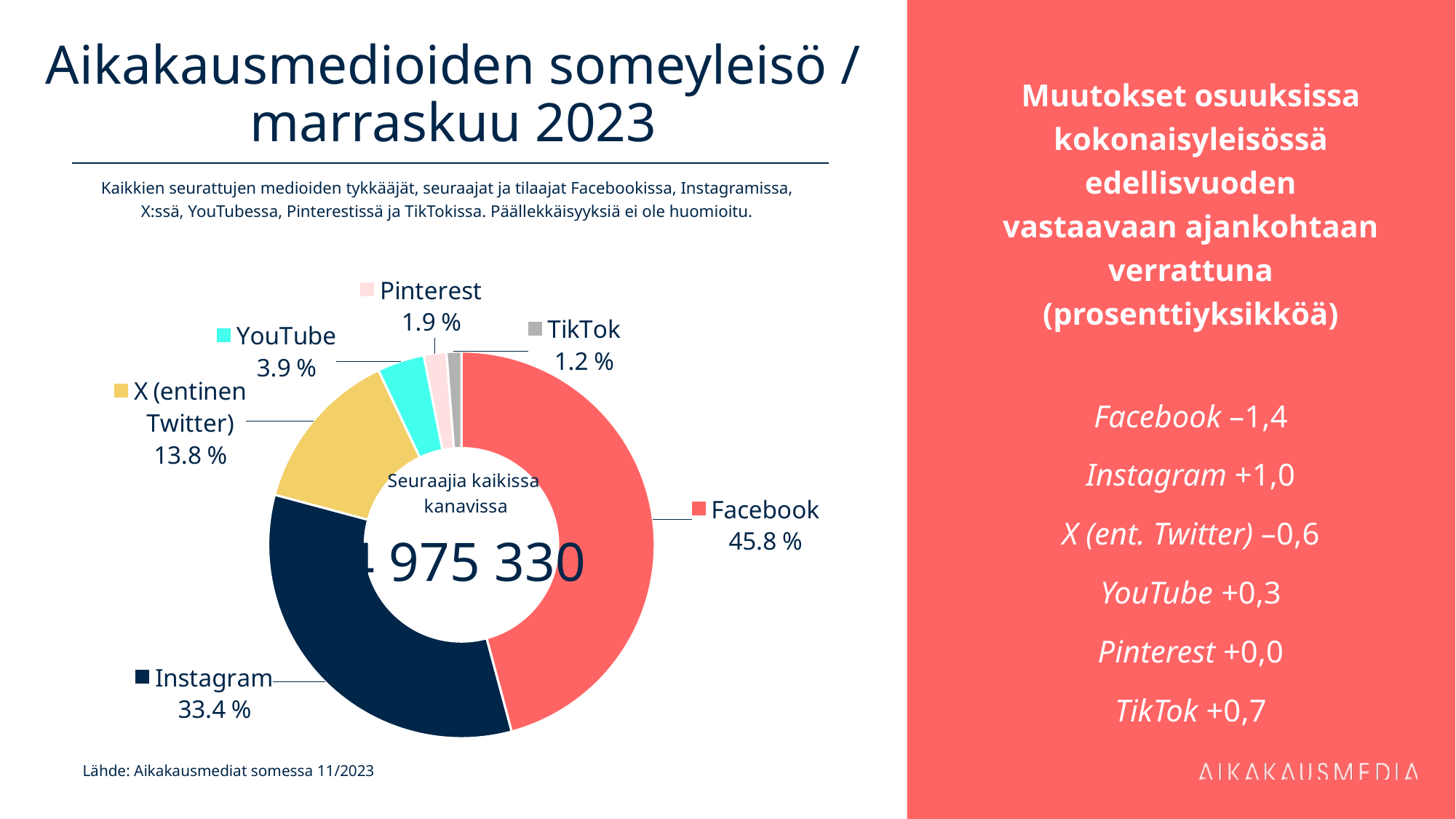
How many channels are shown in the chart? 6 What share is shown for TikTok? 1.2 % Which channel has the smallest share in the chart? TikTok What is the share shown for X (entinen Twitter)? 13.8 % Which has the larger share, Pinterest or YouTube? YouTube What is the source given below the chart? Aikakausmediat somessa 11/2023 How many percentage points larger is Facebook's share than Instagram's? 12.4 What share does Instagram have in the doughnut chart? 33.4 % Which channel has the largest share in the chart? Facebook What share is shown for YouTube? 3.9 % What share of the social media audience does Facebook have? 45.8 % What type of chart is used on the slide? Doughnut chart